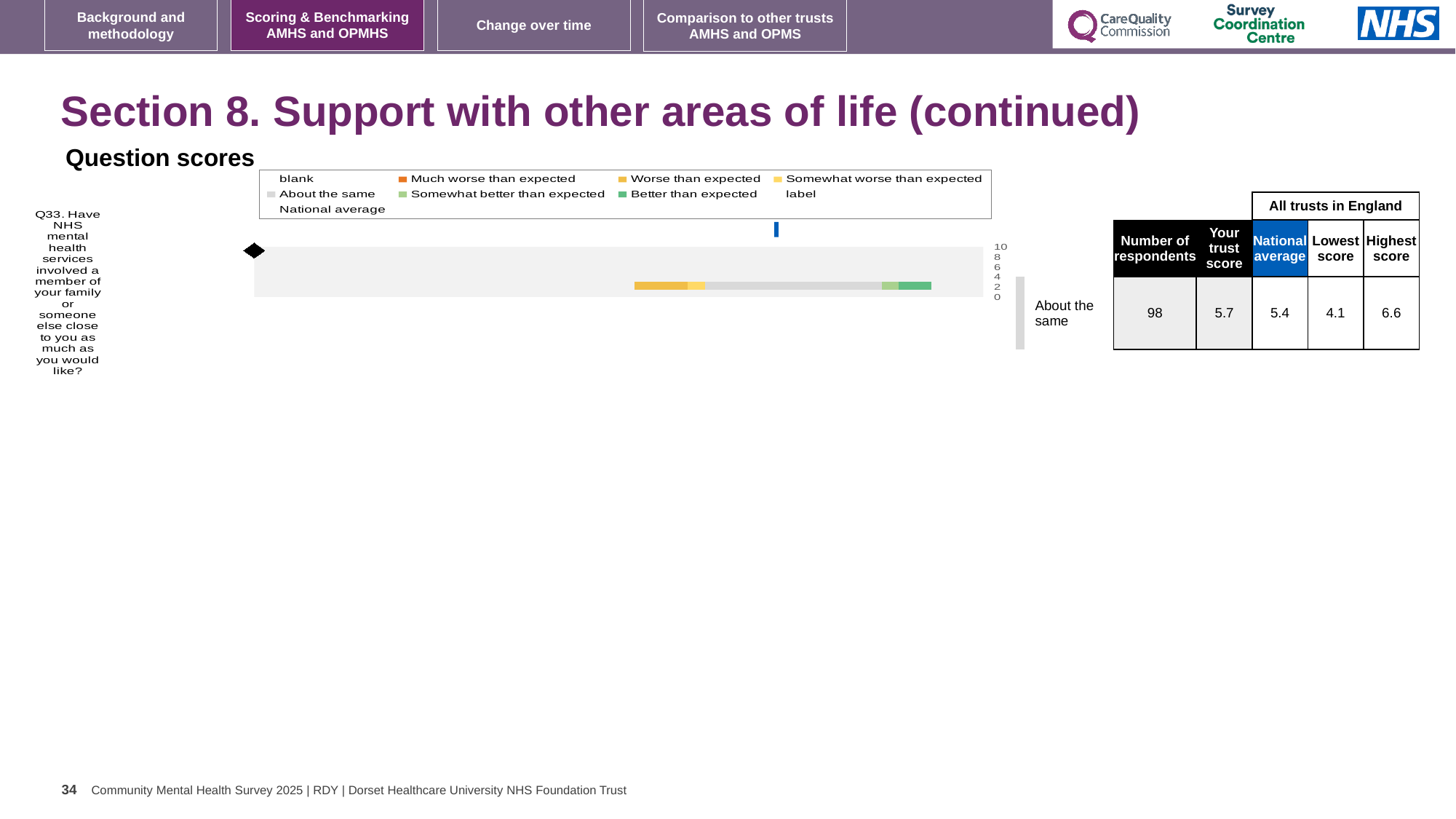
What is the National average score shown for Q33? 5.4 What is the difference between the Highest score and the Lowest score shown for Q33? 2.5 Which benchmark category is the trust's Q33 score placed in? About the same What is the difference between the trust score and the National average for Q33? 0.3 Which question is plotted in the Question scores chart? Q33. Have NHS mental health services involved a member of your family or someone else close to you as much as you would like? Which is larger for Q33, the trust score or the National average? the trust score (5.7) How many survey questions are plotted in the Question scores chart? 1 What is the Lowest score among all trusts in England shown for Q33? 4.1 What is the 'Your trust score' value shown for Q33? 5.7 What is the Highest score among all trusts in England shown for Q33? 6.6 What kind of chart is used to show the Q33 question score? bar chart How many respondents are shown for Q33? 98